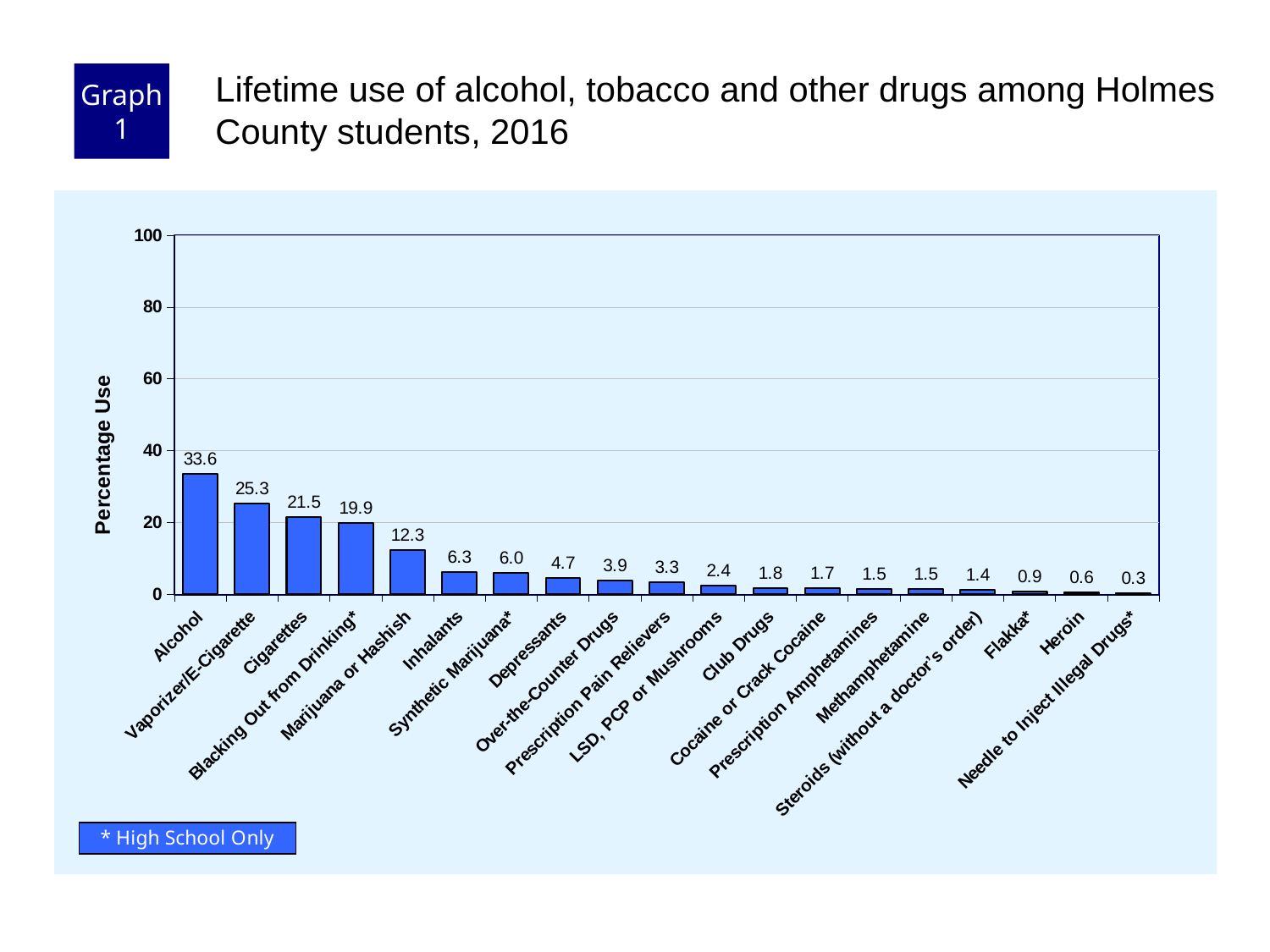
Which category has the highest value? Alcohol Which category has the lowest value? Needle to Inject Illegal Drugs* What is the difference between the values for Vaporizer/E-Cigarette and Blacking Out from Drinking*? 5.4 What is the label of the y axis? Percentage Use What kind of chart is this? bar chart What is the difference between the values for Alcohol and Cigarettes? 12.1 What is the lifetime use percentage for Alcohol? 33.6 Is the value for Vaporizer/E-Cigarette greater or less than 20? greater What is the value shown for Marijuana or Hashish? 12.3 What is the value shown for Heroin? 0.6 How many categories are shown on the x axis? 19 Which is larger, the value for Inhalants or the value for Depressants? Inhalants